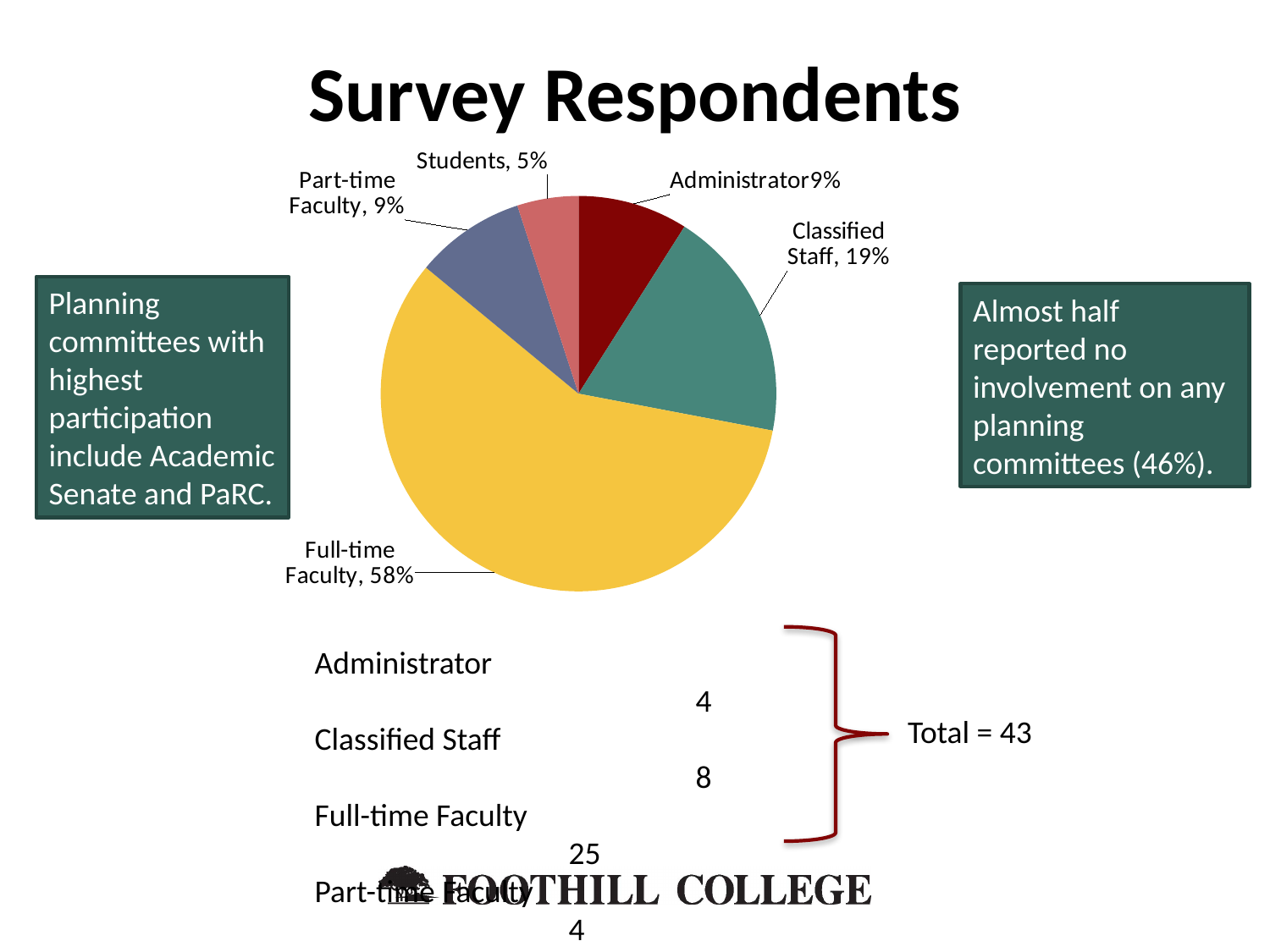
What share of survey respondents are Full-time Faculty? 58% Which slice is larger, Classified Staff or Students? Classified Staff What is the title of the chart? Survey Respondents What kind of chart is shown on the slide? pie chart Which group makes up the smallest slice of the pie chart? Students How many slices does the pie chart have? 5 What is the difference in percentage points between the Full-time Faculty slice and the Classified Staff slice? 39 What share of survey respondents are Part-time Faculty? 9% What share of survey respondents are Students? 5% What share of survey respondents are Administrators? 9% What share of survey respondents are Classified Staff? 19% Which group makes up the largest slice of the pie chart? Full-time Faculty